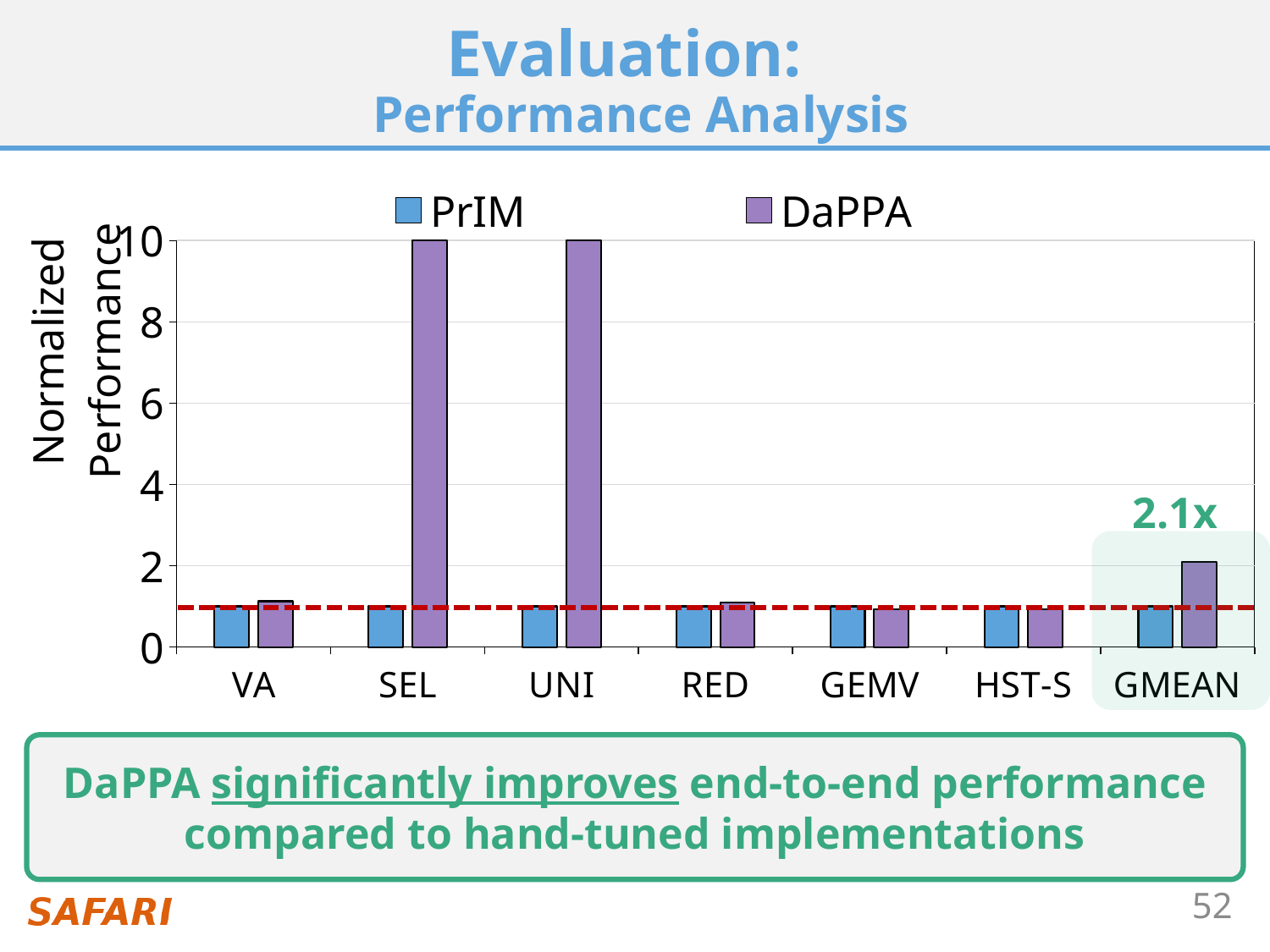
What is the label of the y axis? Normalized Performance Is the DaPPA value for VA greater or less than 2? less Is the DaPPA value for UNI greater or less than 6? greater How many series does the legend list? 2 Is the DaPPA value for SEL greater or less than 8? greater How many categories are shown on the x axis? 7 What are the two series named in the legend? PrIM and DaPPA Which is larger, the DaPPA value for SEL or the DaPPA value for RED? SEL What value is labelled above the DaPPA bar for GMEAN? 2.1x What kind of chart is shown on the slide? bar chart For GMEAN, which series has the larger value, PrIM or DaPPA? DaPPA